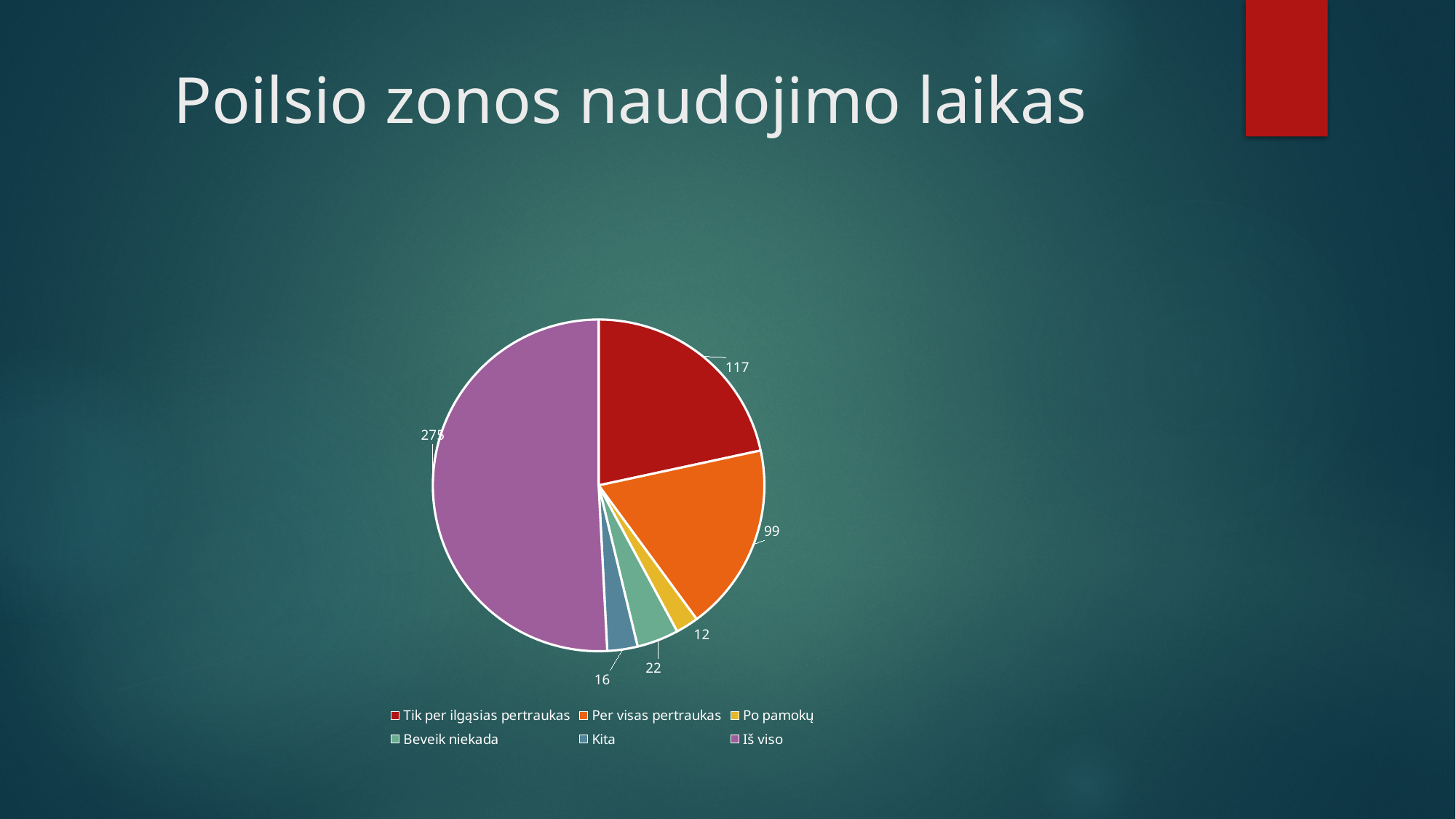
What is the value for "Po pamokų"? 12 How many slices does the pie chart have? 6 Which slice has the smallest value? Po pamokų What type of chart is shown on the slide? pie chart What is the value for "Per visas pertraukas"? 99 What is the title of the slide containing the chart? Poilsio zonos naudojimo laikas What is the difference between the values for "Tik per ilgąsias pertraukas" and "Per visas pertraukas"? 18 What is the value for "Tik per ilgąsias pertraukas"? 117 Which slice has the largest value? Iš viso What is the value for "Beveik niekada"? 22 Which is larger, the value for "Beveik niekada" or the value for "Kita"? Beveik niekada What is the value for "Kita"? 16